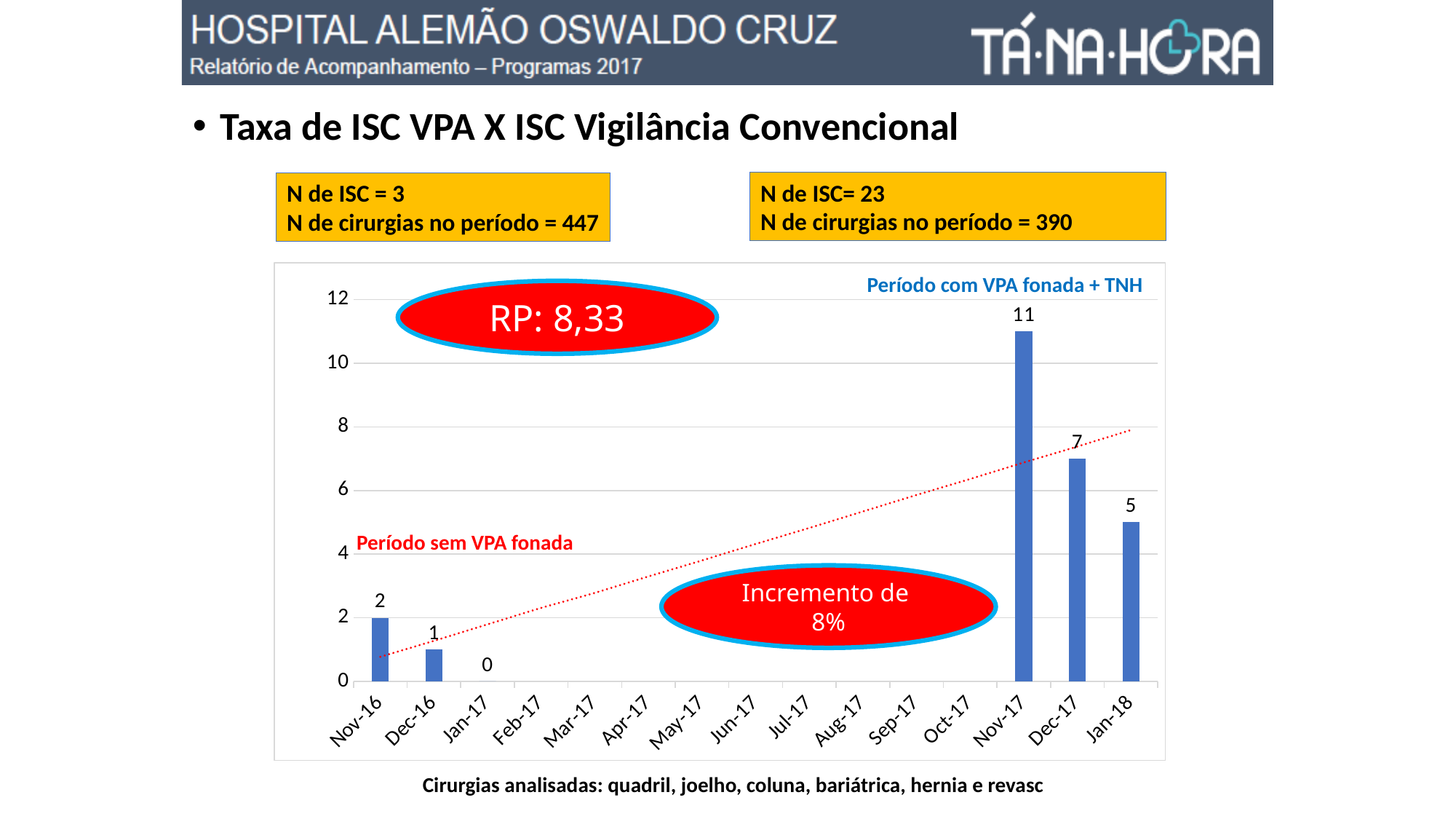
What is the value for Nov-17? 11 What is the value for Nov-16? 2 What is the difference between the values for Nov-16 and Dec-16? 1 What kind of chart is shown? bar chart How many months are shown on the x axis? 15 What is the difference between the values for Nov-17 and Dec-17? 4 Is the value for Nov-17 greater or less than 10? greater What is the value for Jan-17? 0 What is the value for Jan-18? 5 What is the value for Dec-17? 7 Which month has the highest value? Nov-17 Which is larger, the value for Dec-17 or the value for Jan-18? Dec-17